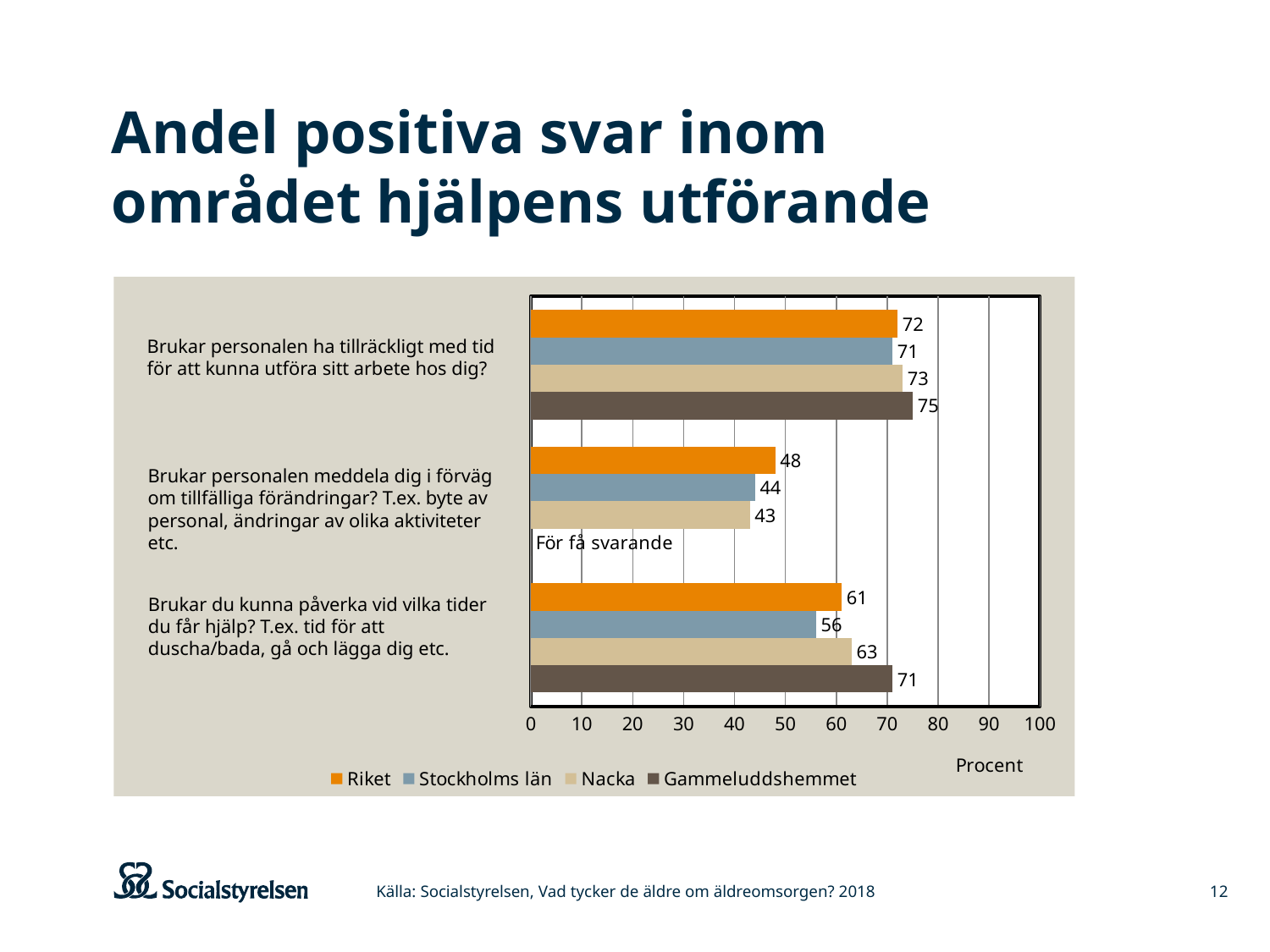
How many series does the legend list? 4 What is the value for Riket on the question "Brukar personalen meddela dig i förväg om tillfälliga förändringar?"? 48 Which is larger on the question "Brukar personalen meddela dig i förväg om tillfälliga förändringar?": Riket or Stockholms län? Riket Which series has the highest value on the question "Brukar du kunna påverka vid vilka tider du får hjälp?"? Gammeluddshemmet Which series has the lowest value on the question "Brukar personalen meddela dig i förväg om tillfälliga förändringar?"? Nacka What text is shown instead of a bar for Gammeluddshemmet on the question "Brukar personalen meddela dig i förväg om tillfälliga förändringar?"? För få svarande How many question categories are shown on the chart? 3 What is the value for Stockholms län on the question "Brukar du kunna påverka vid vilka tider du får hjälp?"? 56 What is the value for Gammeluddshemmet on the question "Brukar personalen ha tillräckligt med tid för att kunna utföra sitt arbete hos dig?"? 75 What kind of chart is shown on the slide? Bar chart What is the value for Nacka on the question "Brukar du kunna påverka vid vilka tider du får hjälp?"? 63 What is the difference between Gammeluddshemmet and Stockholms län on the question "Brukar du kunna påverka vid vilka tider du får hjälp?"? 15